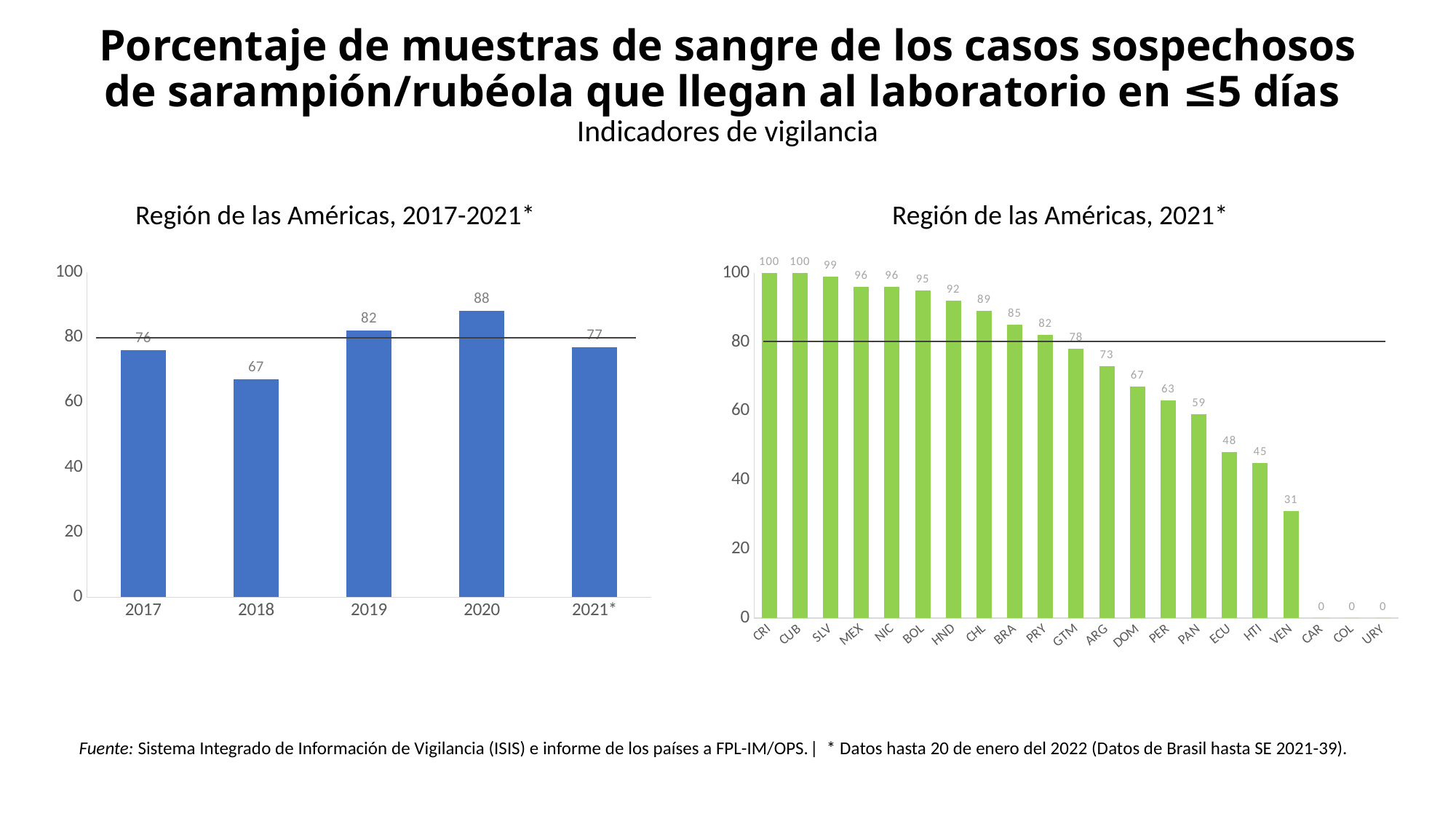
In the chart 'Región de las Américas, 2017-2021*', how many years are shown on the x axis? 5 In the chart 'Región de las Américas, 2017-2021*', what is the value for 2020? 88 In the chart 'Región de las Américas, 2017-2021*', is the value for 2019 greater or less than 80? greater In the chart 'Región de las Américas, 2021*', which is larger, the value for ARG or the value for PER? ARG In the chart 'Región de las Américas, 2021*', what is the value for VEN? 31 In the chart 'Región de las Américas, 2021*', do the values rise or fall from left to right along the x axis? Fall In the chart 'Región de las Américas, 2017-2021*', what is the difference between the values for 2020 and 2018? 21 What kind of chart is 'Región de las Américas, 2021*'? Bar chart In the chart 'Región de las Américas, 2021*', how many countries are shown on the x axis? 21 In the chart 'Región de las Américas, 2021*', what is the value for HND? 92 In the chart 'Región de las Américas, 2021*', what is the difference between the values for GTM and ECU? 30 In the chart 'Región de las Américas, 2017-2021*', which year has the lowest value? 2018